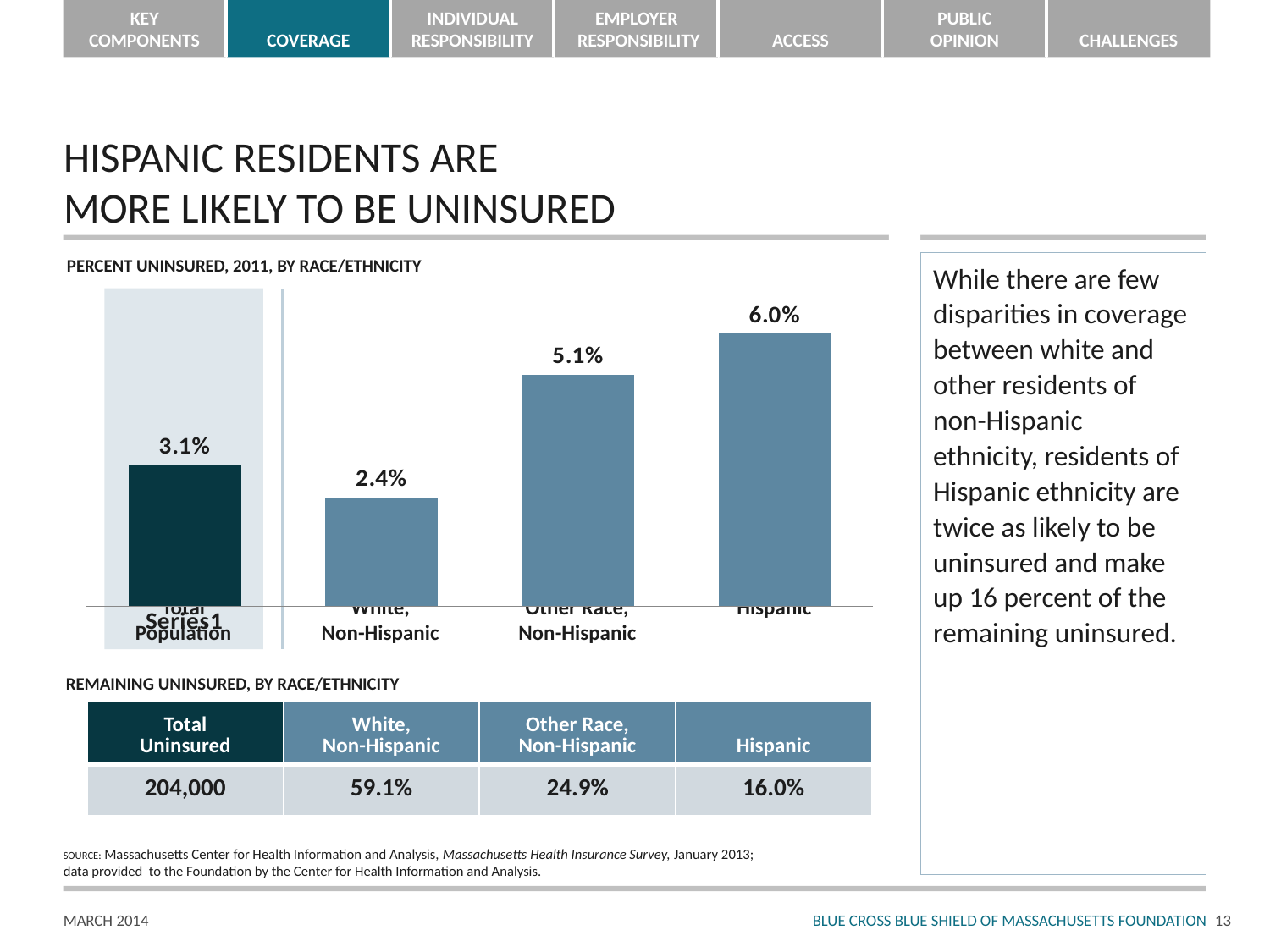
Which race/ethnicity group has the lowest percent uninsured in the chart? White, Non-Hispanic What is the title of the chart on the slide? Percent Uninsured, 2011, by Race/Ethnicity What is the percent uninsured for the Total Population bar? 3.1% What is the percent uninsured for White, Non-Hispanic residents? 2.4% What is the percent uninsured for Hispanic residents in the chart? 6.0% How many bars are shown in the percent uninsured chart? 4 Which is larger: the percent uninsured for Other Race, Non-Hispanic residents or for the Total Population? Other Race, Non-Hispanic What type of chart is used to show percent uninsured by race/ethnicity? Bar chart What is the difference in percent uninsured between Hispanic and White, Non-Hispanic residents? 3.6% Which race/ethnicity group has the highest percent uninsured in the chart? Hispanic How much higher is the percent uninsured for Other Race, Non-Hispanic residents than for the Total Population? 2.0% What is the percent uninsured for Other Race, Non-Hispanic residents? 5.1%